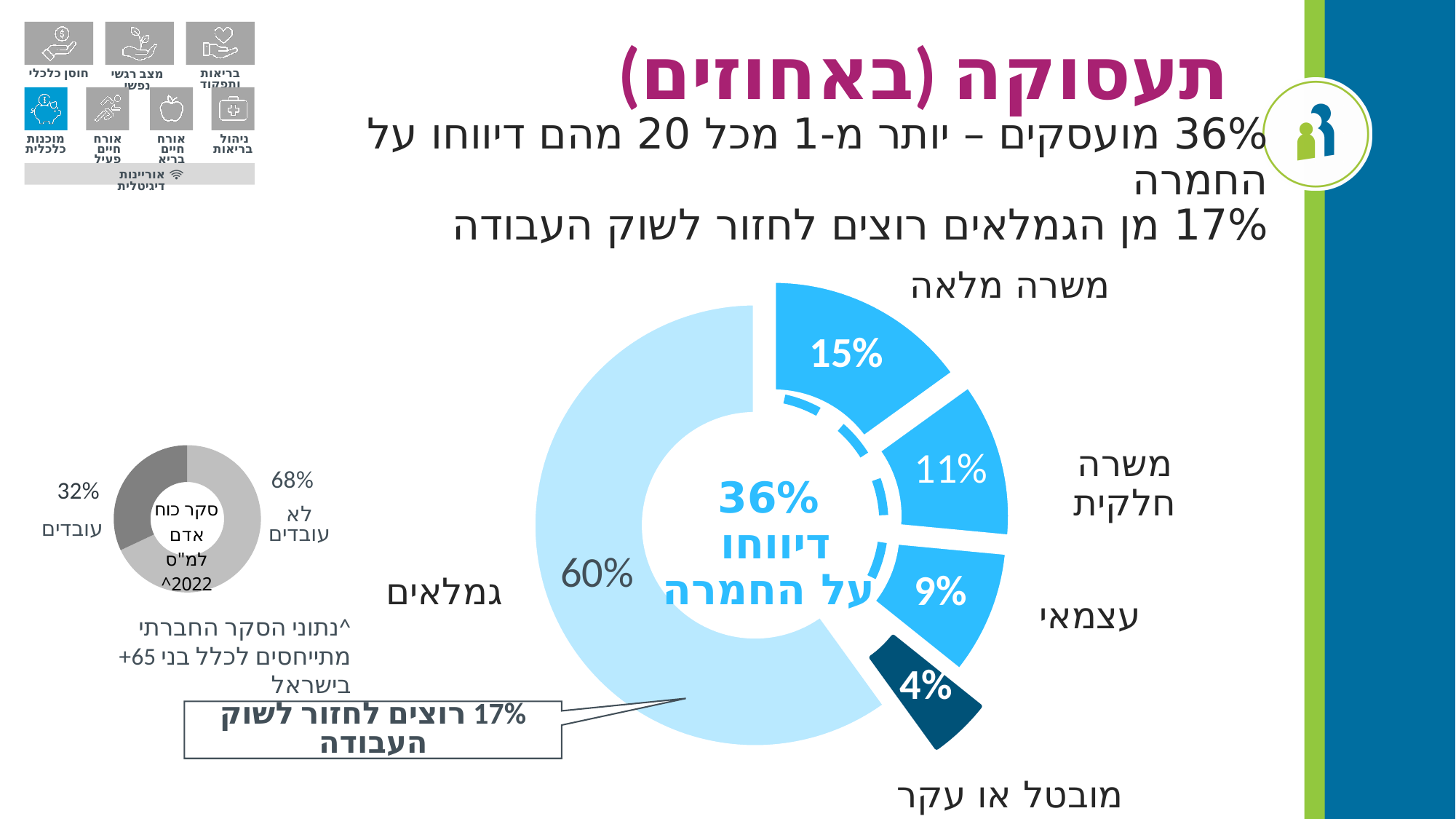
In the large donut chart, what is the value for משרה מלאה? 15% In the large donut chart, what is the value for משרה חלקית? 11% In the small donut chart on the left (סקר כוח אדם למ"ס 2022), what is the value for לא עובדים? 68% How many categories does the large donut chart show? 5 In the large donut chart, which category has the smallest share? מובטל או עקר In the large donut chart, what is the value for עצמאי? 9% In the large donut chart, what is the difference between the share for גמלאים and the share for משרה מלאה? 45% In the large donut chart, which is larger: משרה חלקית or עצמאי? משרה חלקית What kind of chart is the large chart in the centre of the slide? Donut chart In the small donut chart on the left (סקר כוח אדם למ"ס 2022), what is the value for עובדים? 32% In the large donut chart, which category has the largest share? גמלאים In the large donut chart, what is the value for מובטל או עקר? 4%